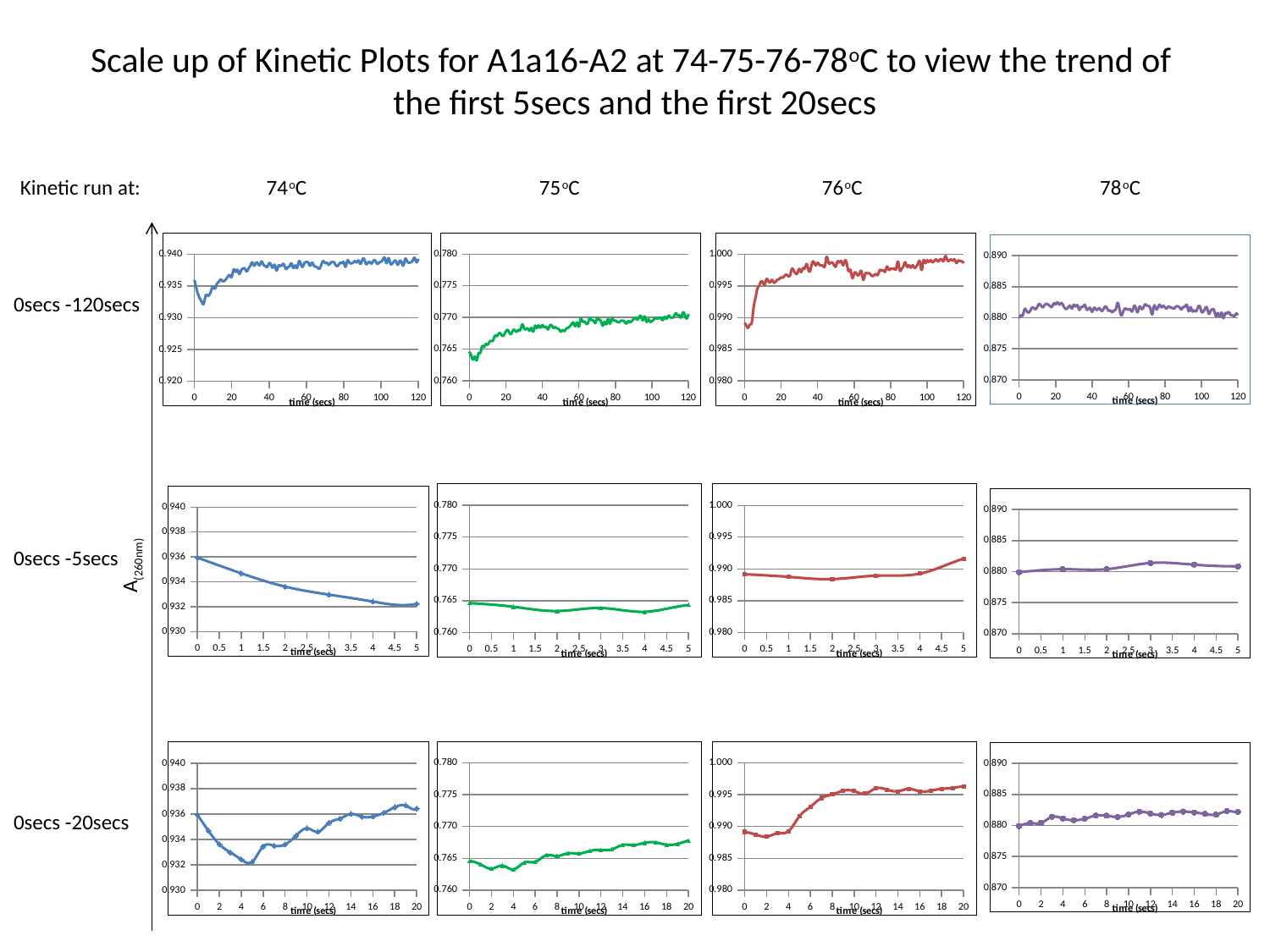
In the 76°C 0secs-5secs chart, is the value at 0 seconds greater or less than 0.985? greater In the 74°C 0secs-5secs chart, is the value at 5 seconds greater or less than 0.934? less In the 74°C 0secs-5secs chart, which time point has the highest value? 0 secs How many data points are plotted in the 74°C 0secs-5secs chart? 6 What kind of chart is used for the 74°C 0secs-120secs plot (top-left)? line chart In the 76°C 0secs-20secs chart, is the value at 20 seconds greater or less than 0.990? greater What is the x-axis label on the 78°C 0secs-20secs chart? time (secs) In the 76°C 0secs-20secs chart, do the values rise or fall overall from 0 to 20 seconds? rise In the 76°C 0secs-5secs chart, which time point has the highest value? 5 secs In the 75°C 0secs-120secs chart, do the values rise or fall overall along the time axis? rise In the 74°C 0secs-5secs chart, do the values rise or fall from 0 to 5 seconds? fall